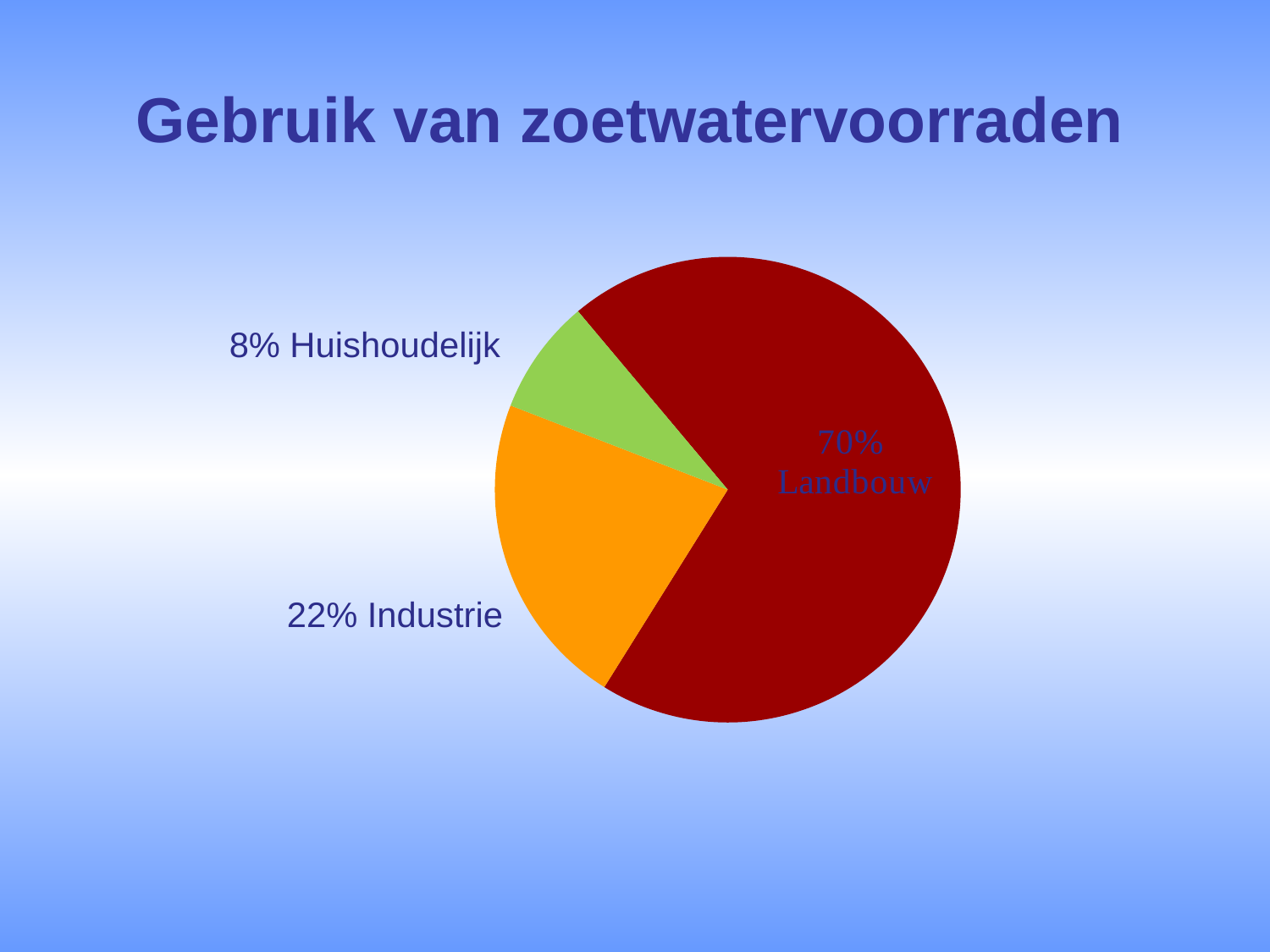
What share of the pie does Industrie represent? 22% What is the difference in percentage points between Industrie and Huishoudelijk? 14 What colour is the Industrie slice of the pie? orange What is the difference in percentage points between Landbouw and Industrie? 48 What is the title of the slide containing the pie chart? Gebruik van zoetwatervoorraden What share of the pie does Huishoudelijk represent? 8% How many slices does the pie chart have? 3 Which category has the smallest slice of the pie? Huishoudelijk What share of the pie does Landbouw represent? 70% Which category has the largest slice of the pie? Landbouw Which is larger, the share for Industrie or the share for Huishoudelijk? Industrie What kind of chart is shown on the slide? pie chart